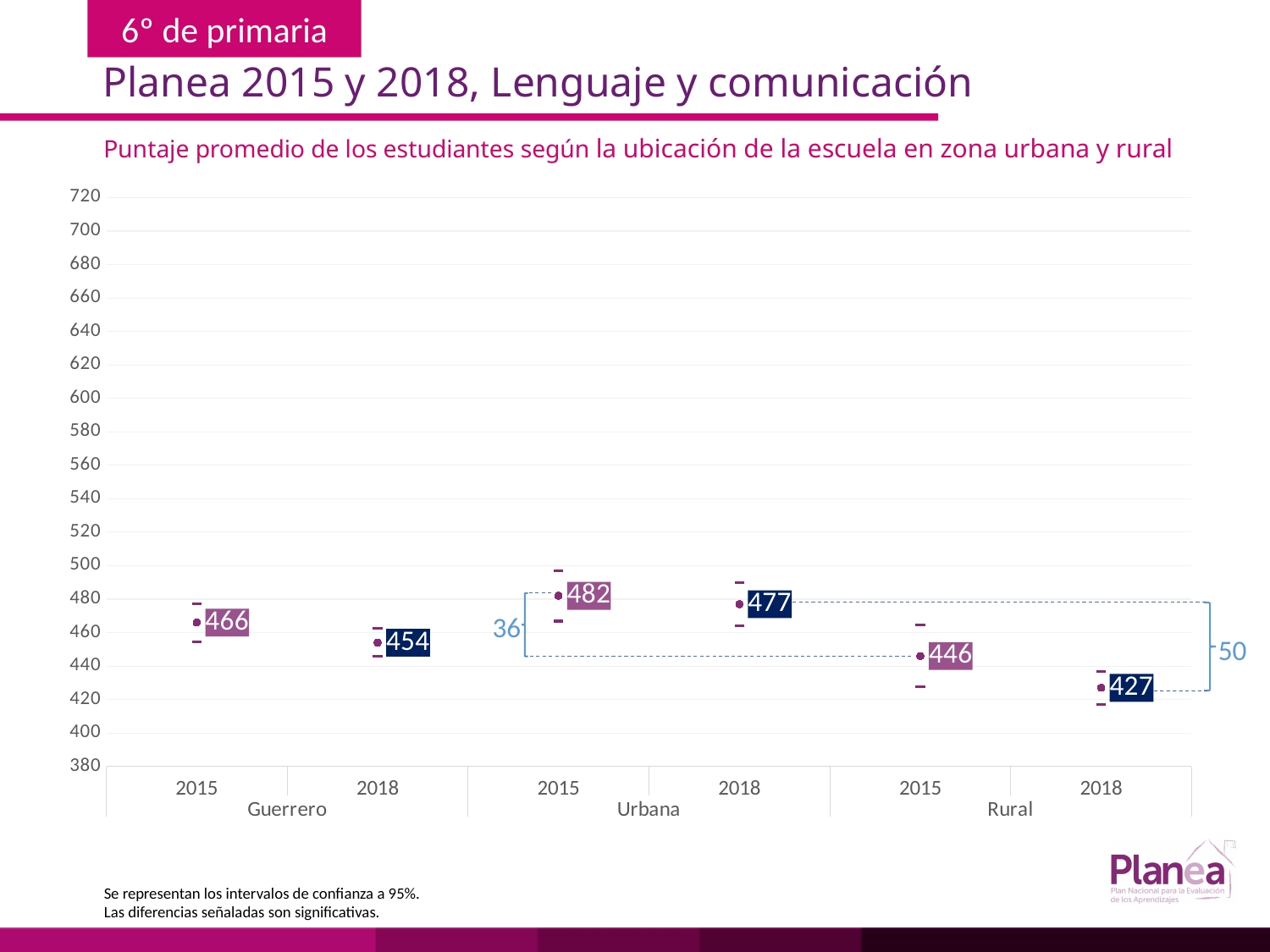
Which is larger, the Guerrero 2015 score or the Rural 2015 score? Guerrero 2015 Did the Rural average score rise or fall from 2015 to 2018? Fall What is the title of the chart? Puntaje promedio de los estudiantes según la ubicación de la escuela en zona urbana y rural What is the average score for Rural schools in 2018? 427 What is the difference between the Urbana and Rural average scores in 2015? 36 What is the average score for Guerrero in 2015? 466 How many data points are plotted on the chart? 6 What is the average score for Guerrero in 2018? 454 What is the average score for Urbana schools in 2015? 482 Which group and year has the highest average score? Urbana 2015 Which group and year has the lowest average score? Rural 2018 What is the difference between the Urbana and Rural average scores in 2018? 50